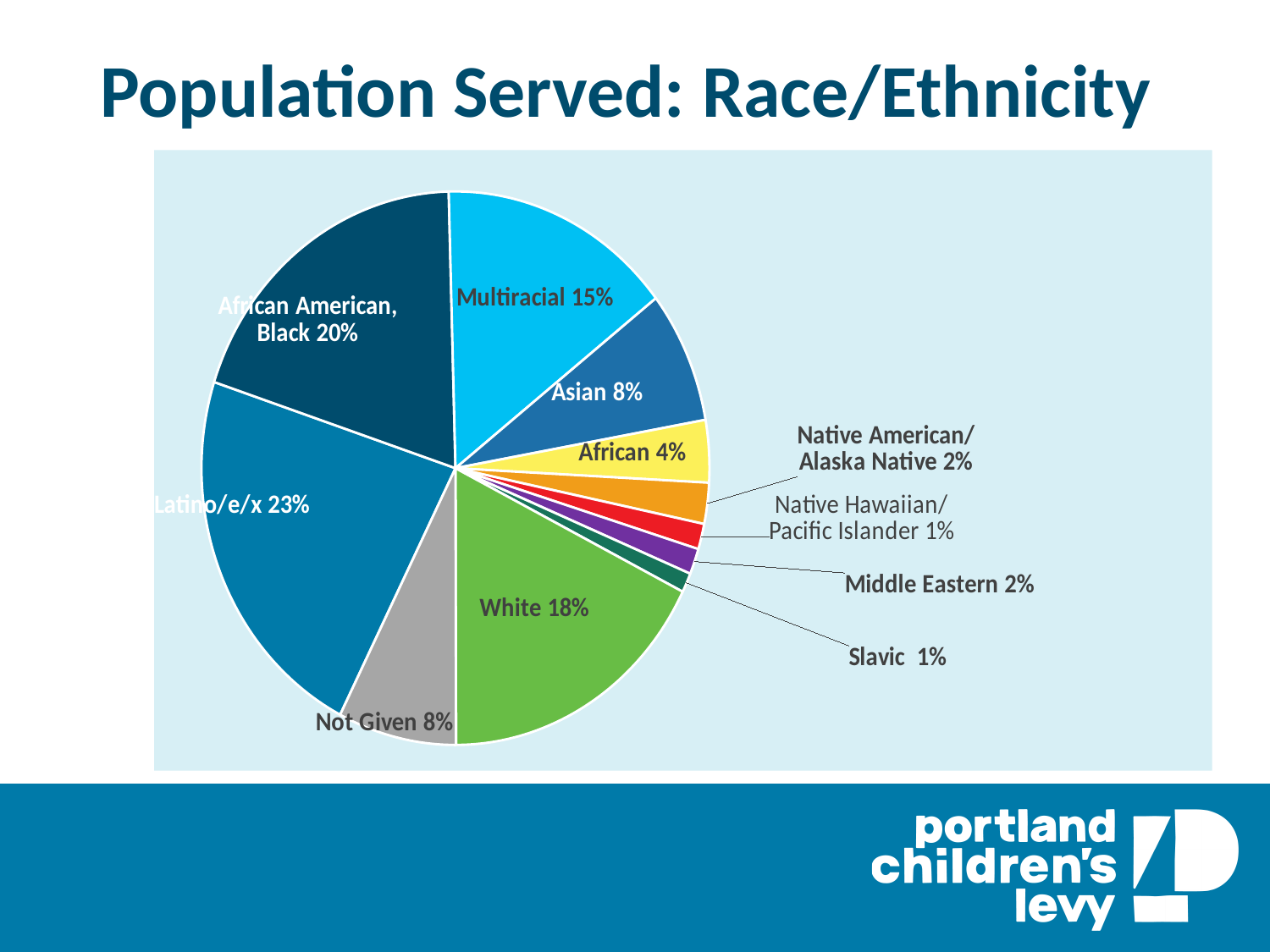
Which is larger, the share for Asian or the share for African? Asian Which category has the largest share of the pie? Latino/e/x What kind of chart is shown on the slide? pie chart What is the title of the chart on the slide? Population Served: Race/Ethnicity What share of the population served is Latino/e/x? 23% What is the difference in percentage points between African American, Black and White? 2 What is the combined share of Middle Eastern and Slavic? 3% How many categories are shown in the pie chart? 11 What percentage is shown for Native American/Alaska Native? 2% What percentage is shown for Native Hawaiian/Pacific Islander? 1% What percentage is shown for Multiracial? 15% What percentage is shown for Not Given? 8%